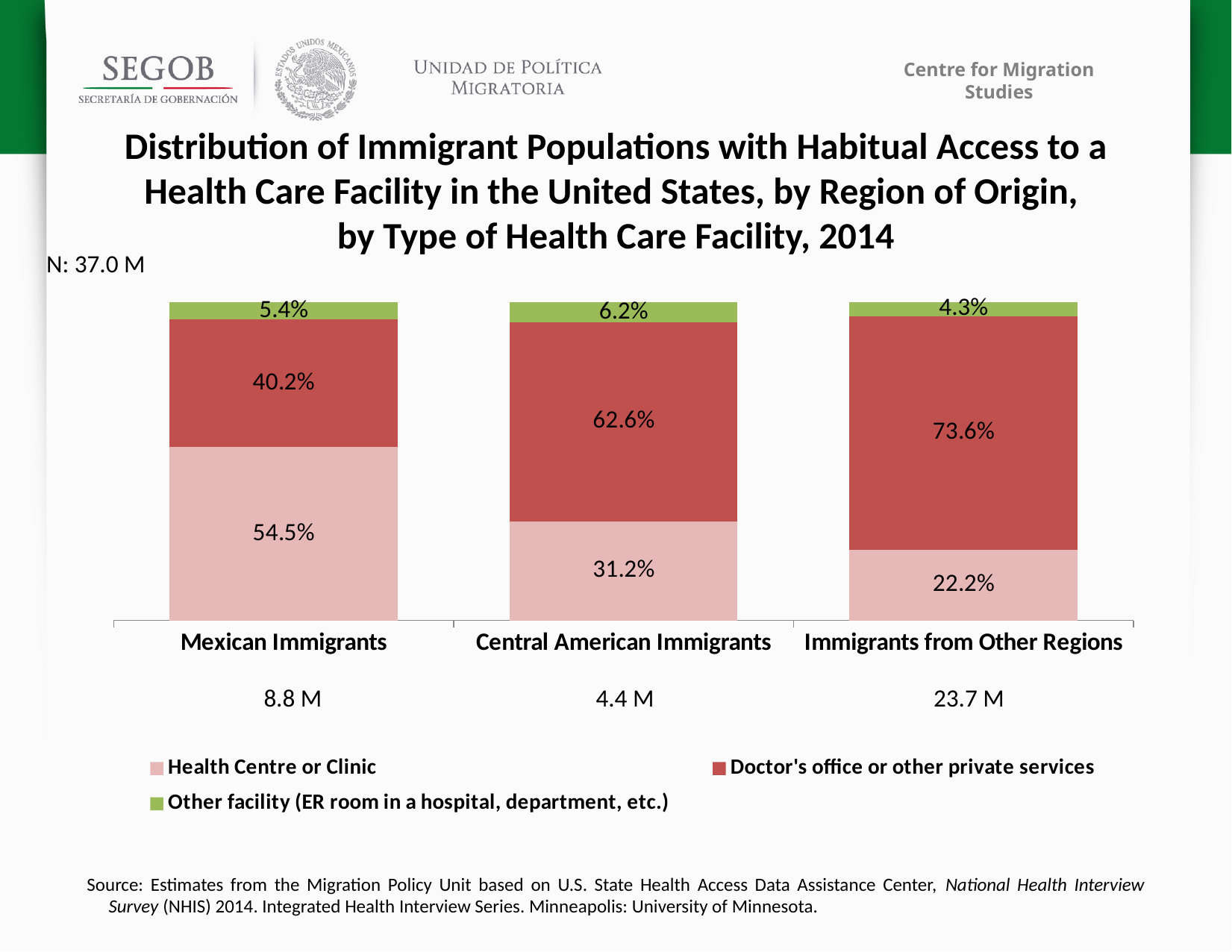
What is the population size shown below the Central American Immigrants bar? 4.4 M Which is larger: the Health Centre or Clinic share for Mexican Immigrants or for Central American Immigrants? Mexican Immigrants How many series does the legend list? 3 What colour represents Other facility (ER room in a hospital, department, etc.) in the legend? Green Which region of origin has the highest share using a Doctor's office or other private services? Immigrants from Other Regions What percentage of Mexican Immigrants use a Health Centre or Clinic? 54.5% How many regions of origin are shown on the x axis? 3 What is the difference in percentage points between the Doctor's office share for Immigrants from Other Regions and for Mexican Immigrants? 33.4 What kind of chart is shown on the slide? Stacked bar chart Which region of origin has the lowest share using a Health Centre or Clinic? Immigrants from Other Regions What percentage of Central American Immigrants use a Doctor's office or other private services? 62.6% What percentage of Immigrants from Other Regions use an Other facility (ER room in a hospital, department, etc.)? 4.3%